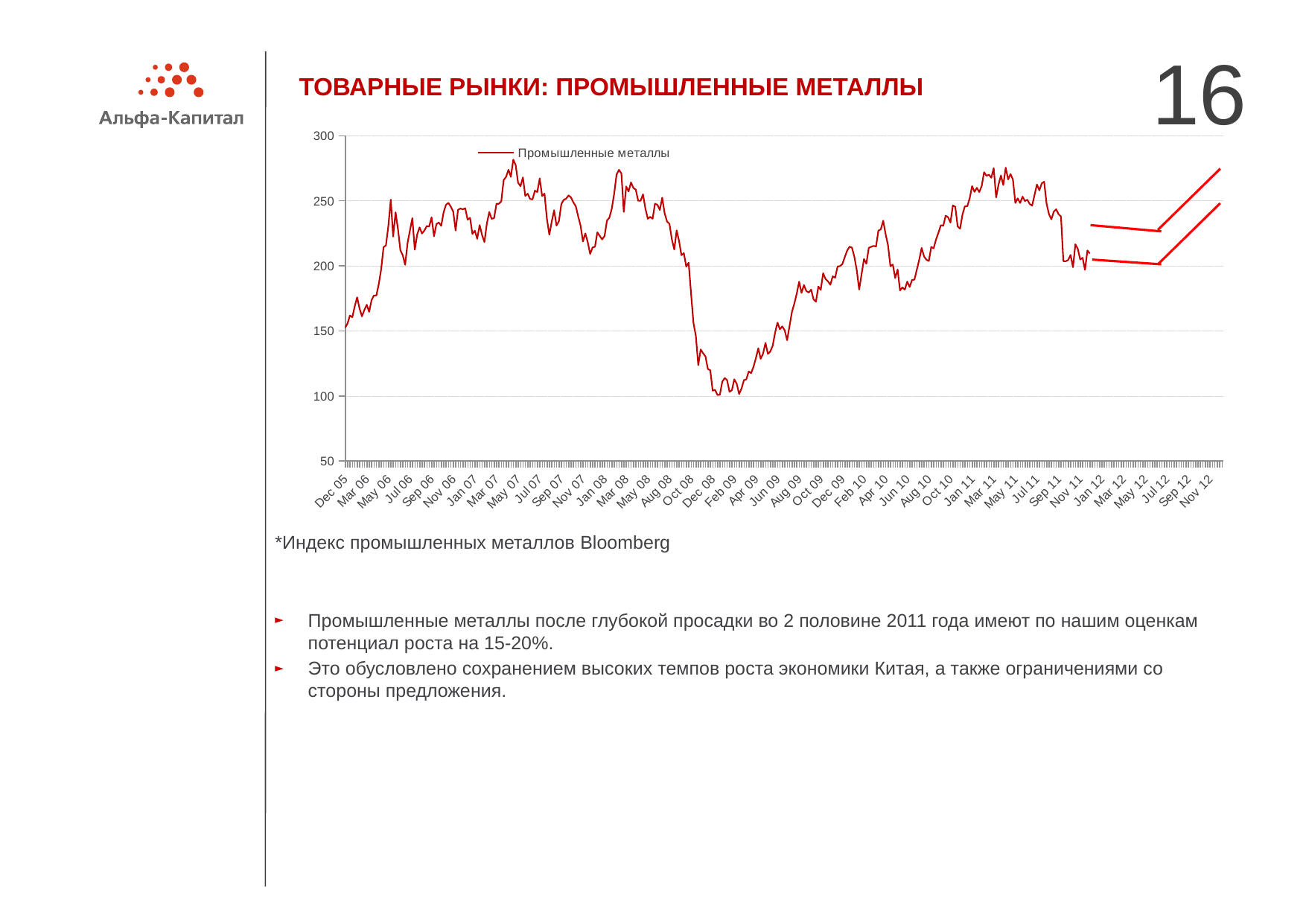
What is the highest value shown on the chart's vertical axis? 300 Is the value of the industrial metals index at Dec 05 greater or less than 200? less What is the name of the series shown in the chart legend? Промышленные металлы Is the value of the industrial metals index at Mar 11 greater or less than 250? greater Which is larger: the index value at Mar 08 or at Feb 09? Mar 08 How many series does the chart legend list? 1 Does the industrial metals index rise or fall between Feb 09 and Mar 11? rise Is the value of the industrial metals index at Feb 09 greater or less than 150? less What kind of chart is shown on the slide? line chart Does the industrial metals index rise or fall between Mar 08 and Feb 09? fall